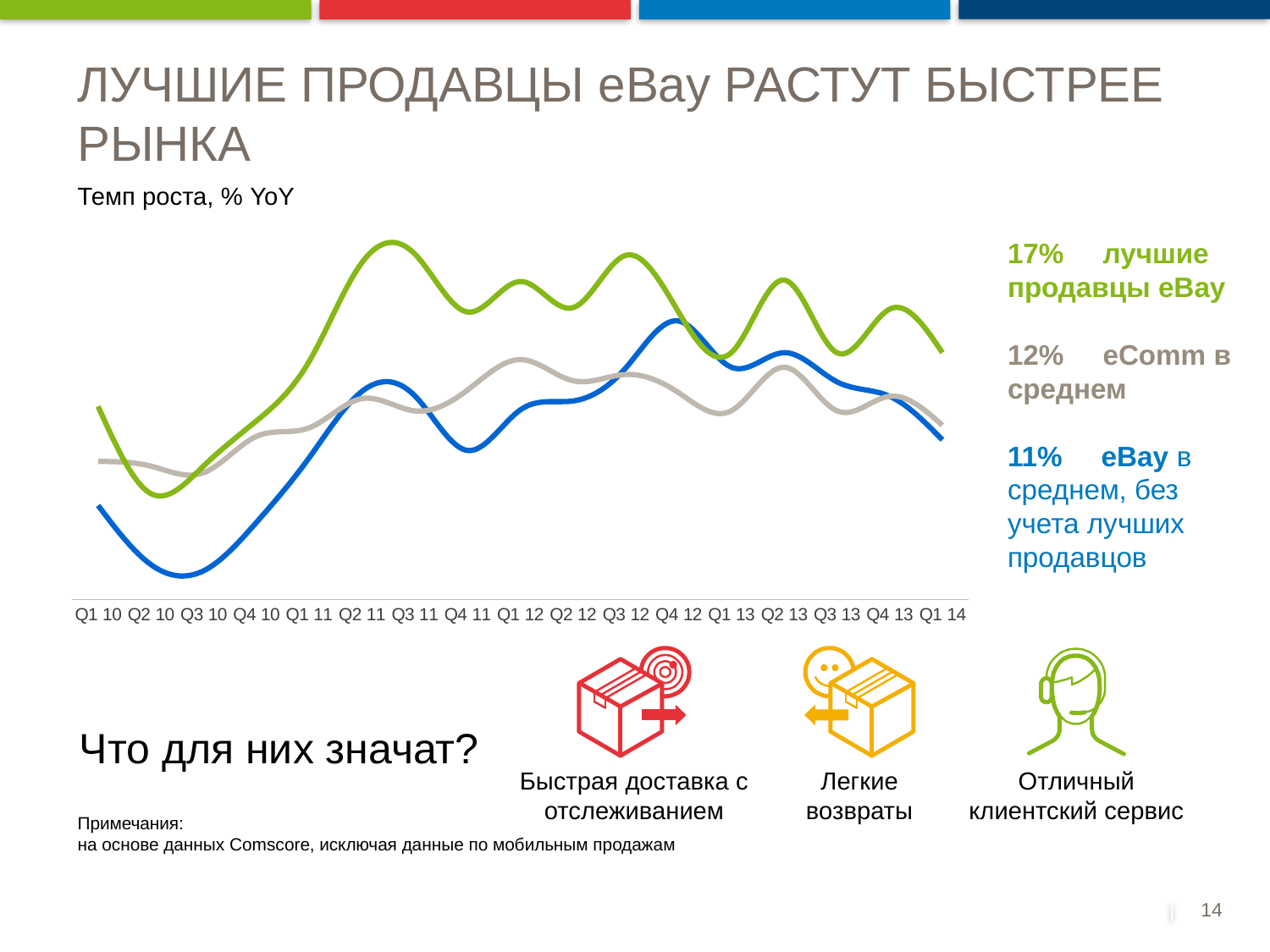
How many quarters are labelled along the x axis of the chart? 17 At Q1 14, which series is higher: лучшие продавцы eBay or eComm в среднем? лучшие продавцы eBay What average growth rate is stated for eComm в среднем? 12% What is the first quarter labelled on the x axis? Q1 10 What kind of chart is shown on the slide? line chart What average growth rate is stated for лучшие продавцы eBay? 17% What is the last quarter labelled on the x axis? Q1 14 Does the line for eBay в среднем, без учета лучших продавцов rise or fall between Q4 12 and Q1 14? fall How many series are plotted in the chart? 3 Does the line for лучшие продавцы eBay rise or fall between Q2 10 and Q3 11? rise Which series has the highest value at Q3 11? лучшие продавцы eBay Which series has the lowest value at Q1 10? eBay в среднем, без учета лучших продавцов